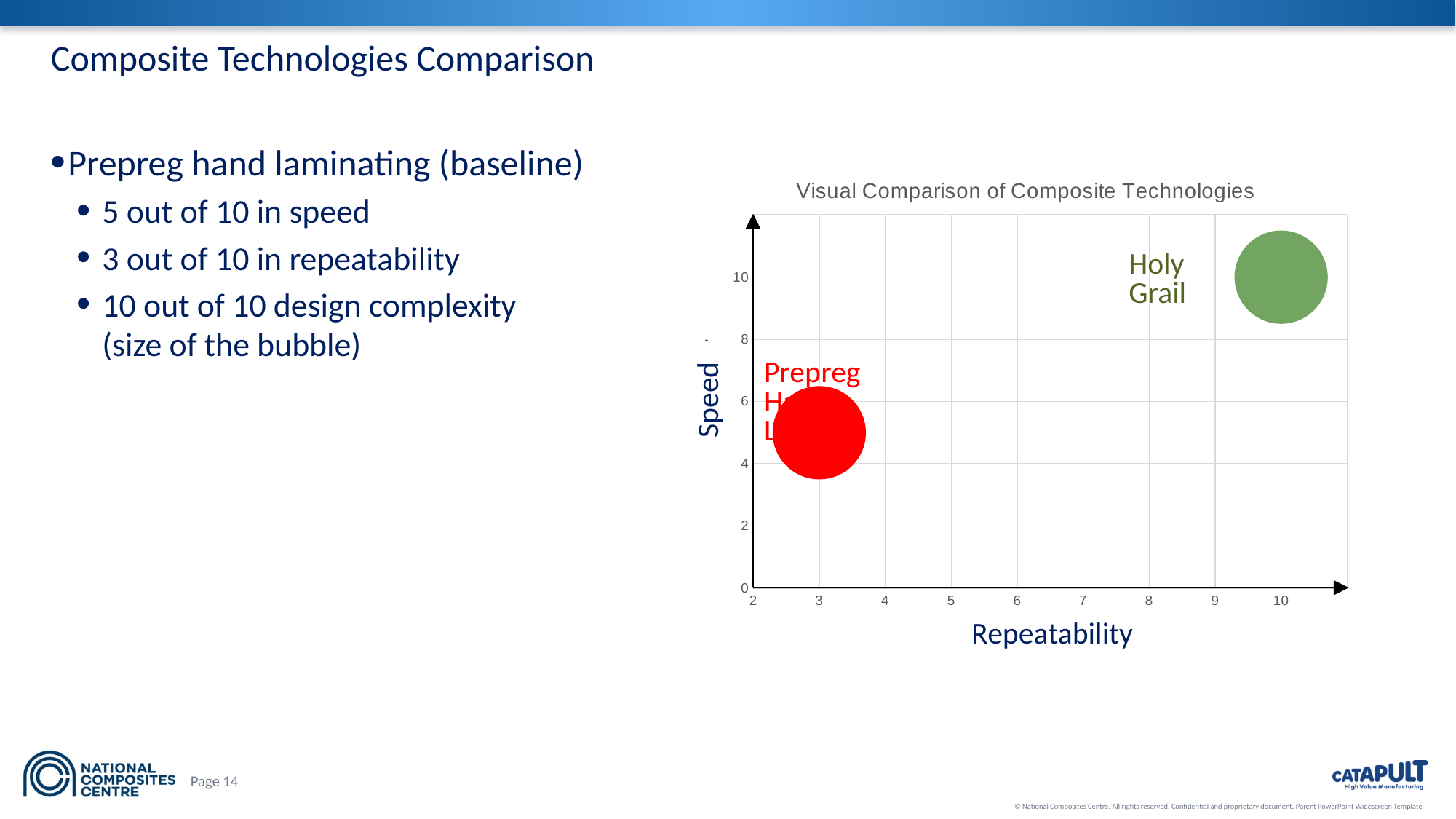
What is the label of the horizontal axis of the chart? Repeatability What is the difference in repeatability between Holy Grail and Prepreg Hand Laminating? 7 Which bubble has the lower repeatability? Prepreg Hand Laminating What is the speed value of the Holy Grail bubble? 10 How many bubbles are plotted in the chart? 2 What is the speed value of the Prepreg Hand Laminating bubble? 5 What is the title of the chart? Visual Comparison of Composite Technologies What is the repeatability value of the Prepreg Hand Laminating bubble? 3 Is the speed value for Prepreg Hand Laminating greater or less than 8? less What is the repeatability value of the Holy Grail bubble? 10 What kind of chart is shown on the slide? bubble chart Which bubble has the higher speed, Prepreg Hand Laminating or Holy Grail? Holy Grail